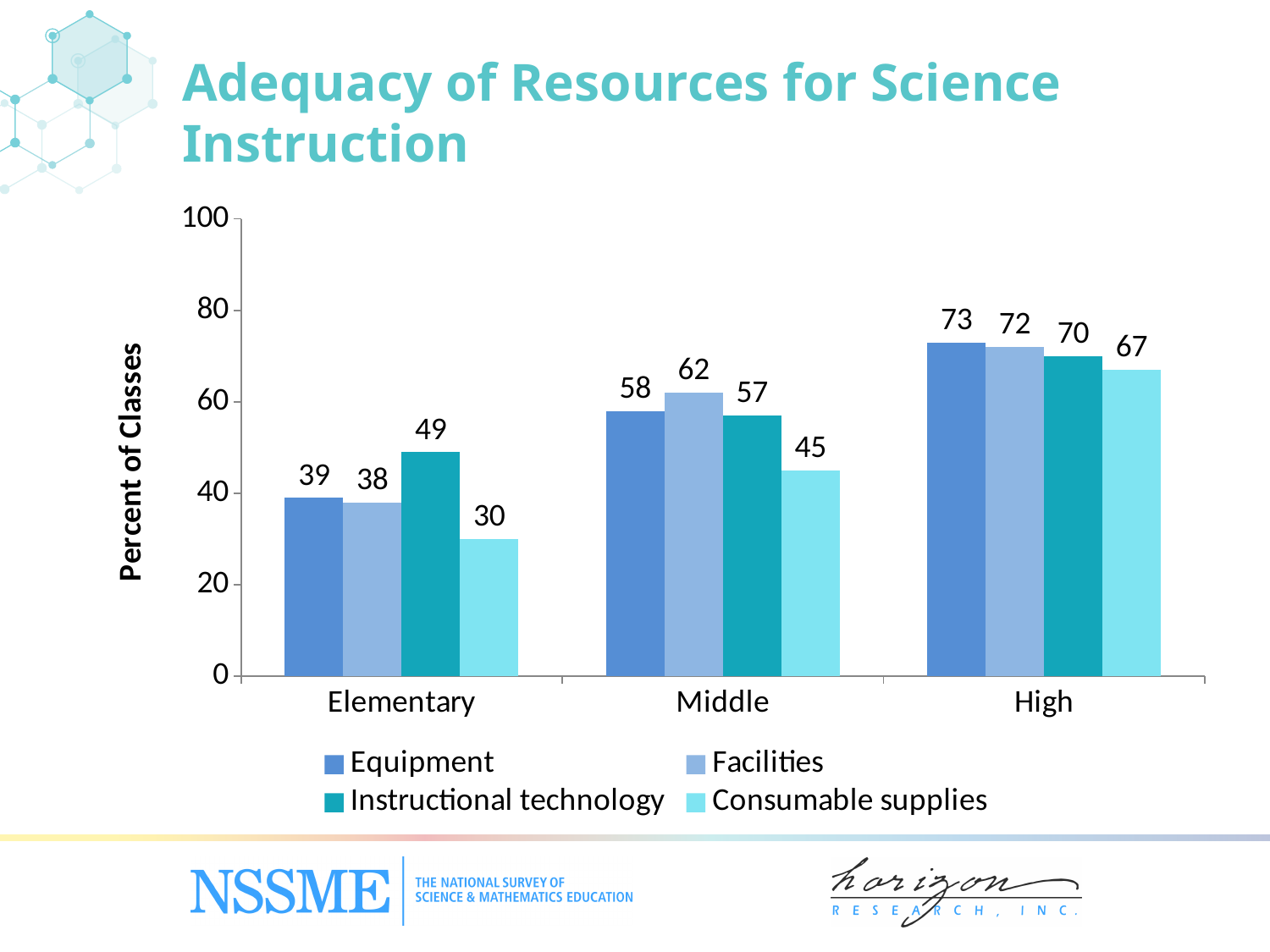
Do the Equipment values rise or fall from Elementary to High? Rise What is the value for Consumable supplies in Middle classes? 45 How many grade-level categories are shown on the x axis? 3 What is the value for Equipment in Elementary classes? 39 What is the label on the y axis? Percent of Classes What is the value for Instructional technology in High classes? 70 Which series has the highest value for Middle classes? Facilities How many series does the legend list? 4 Which is larger: Instructional technology for Elementary or Consumable supplies for Middle? Instructional technology for Elementary What is the difference between the Facilities values for High and Elementary classes? 34 What kind of chart is shown on the slide? Bar chart Which series has the lowest value for Elementary classes? Consumable supplies